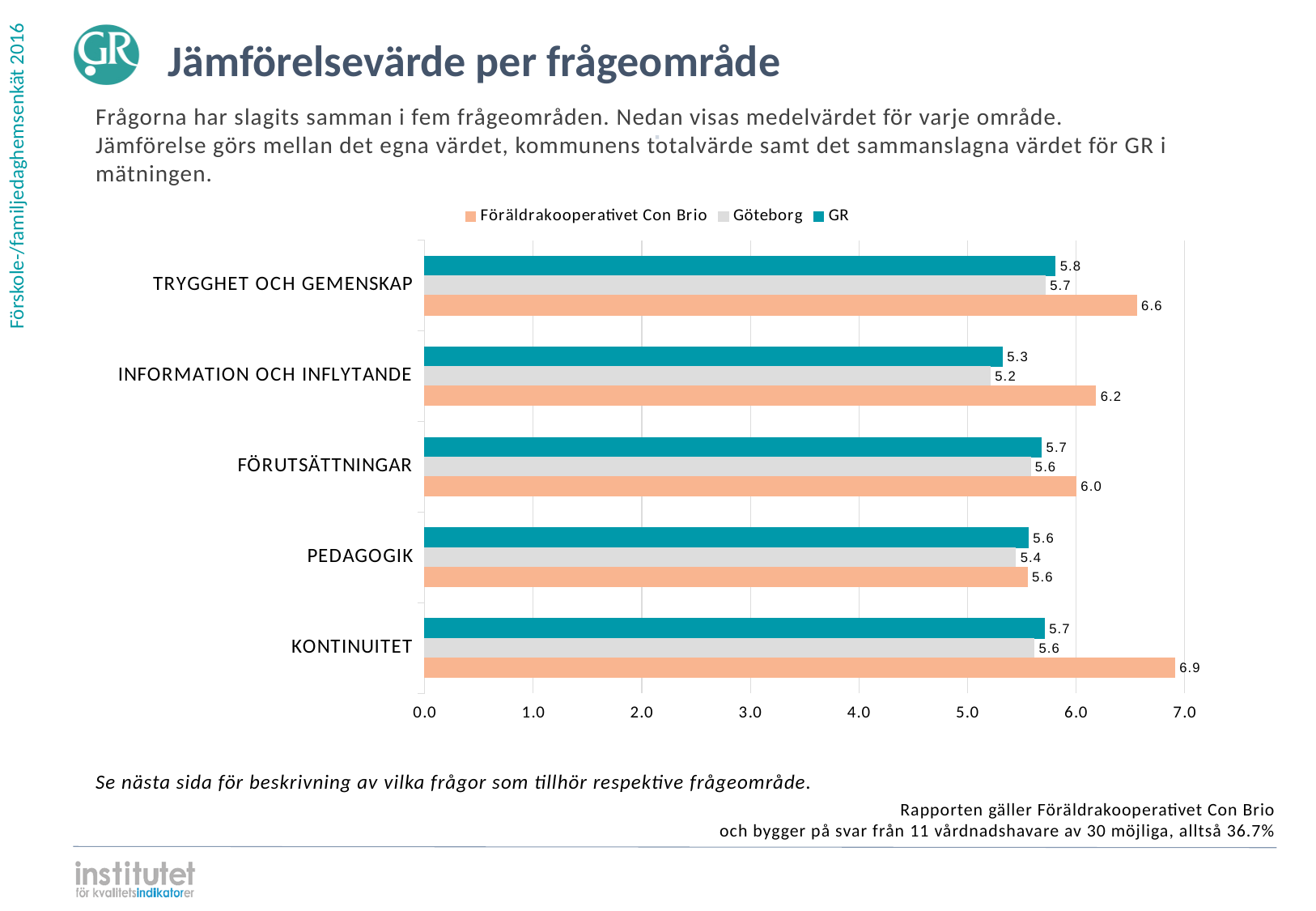
What is the value for Göteborg in the PEDAGOGIK category? 5.4 What is the difference between the Föräldrakooperativet Con Brio value and the GR value in the TRYGGHET OCH GEMENSKAP category? 0.8 Which category has the lowest value for Göteborg? INFORMATION OCH INFLYTANDE Which category has the highest value for Föräldrakooperativet Con Brio? KONTINUITET Which is larger in the FÖRUTSÄTTNINGAR category: the Föräldrakooperativet Con Brio value or the Göteborg value? Föräldrakooperativet Con Brio Which series is shown in orange in the chart? Föräldrakooperativet Con Brio How many series does the legend list? 3 What is the value for Föräldrakooperativet Con Brio in the KONTINUITET category? 6.9 What kind of chart is shown on the slide? bar chart What is the title of the chart on the slide? Jämförelsevärde per frågeområde How many categories are shown on the chart? 5 What is the value for GR in the INFORMATION OCH INFLYTANDE category? 5.3